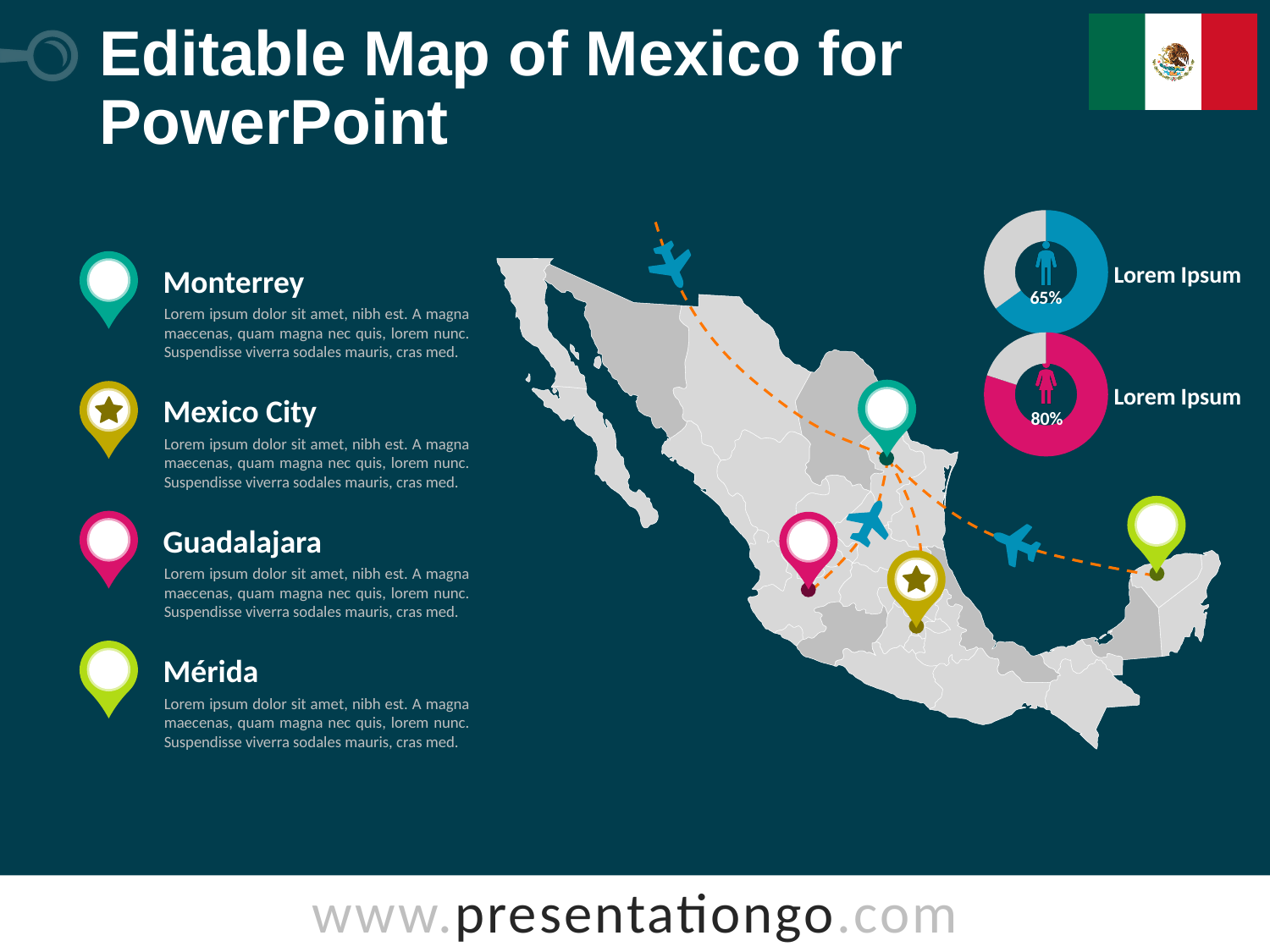
Which of the two donut charts shows the larger percentage, the upper blue one or the lower pink one? the lower pink one Is the value on the upper blue donut chart greater or less than 50%? greater Which donut chart shows the smallest percentage? the upper blue one (65%) What kind of chart is used to display the 65% and 80% values? donut chart What value is shown on the lower donut chart (pink, with the female icon)? 80% What colour is the filled portion of the donut chart showing 80%? pink Is the value on the lower pink donut chart greater or less than 75%? greater What label appears next to the upper blue donut chart? Lorem Ipsum What value is shown on the upper donut chart (blue, with the male icon)? 65% How many donut charts are shown on the right side of the slide? 2 What is the difference between the percentages shown on the lower pink donut chart and the upper blue donut chart? 15%